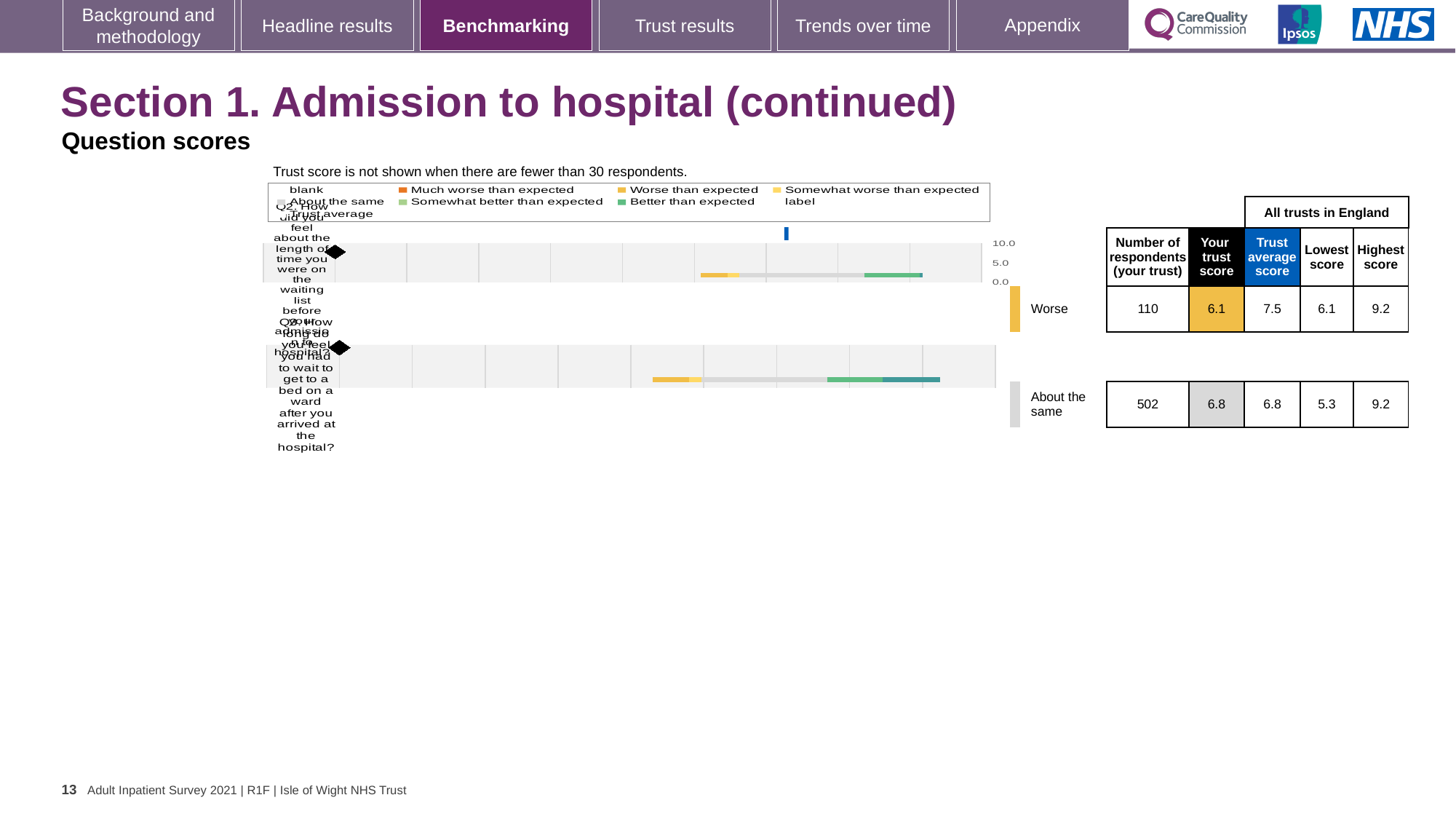
What is the difference between the all-trusts average score and the trust score for Q2? 1.4 What is the trust average score across all trusts in England for Q3? 6.8 What is the highest score across all trusts in England for Q2? 9.2 What is the lowest score across all trusts in England for Q3? 5.3 Is the trust score for Q2 greater or less than 5.0? greater What kind of chart is used to show the question scores? Bar chart What is the trust score for Q3 (how long did you feel you had to wait to get to a bed on a ward)? 6.8 What is the trust score for Q2 (how did you feel about the length of time on the waiting list before admission)? 6.1 How many questions are plotted on the chart? 2 Which question has the higher trust score, Q2 or Q3? Q3 What benchmark category is shown for Q3? About the same How many respondents from the trust answered Q2? 110